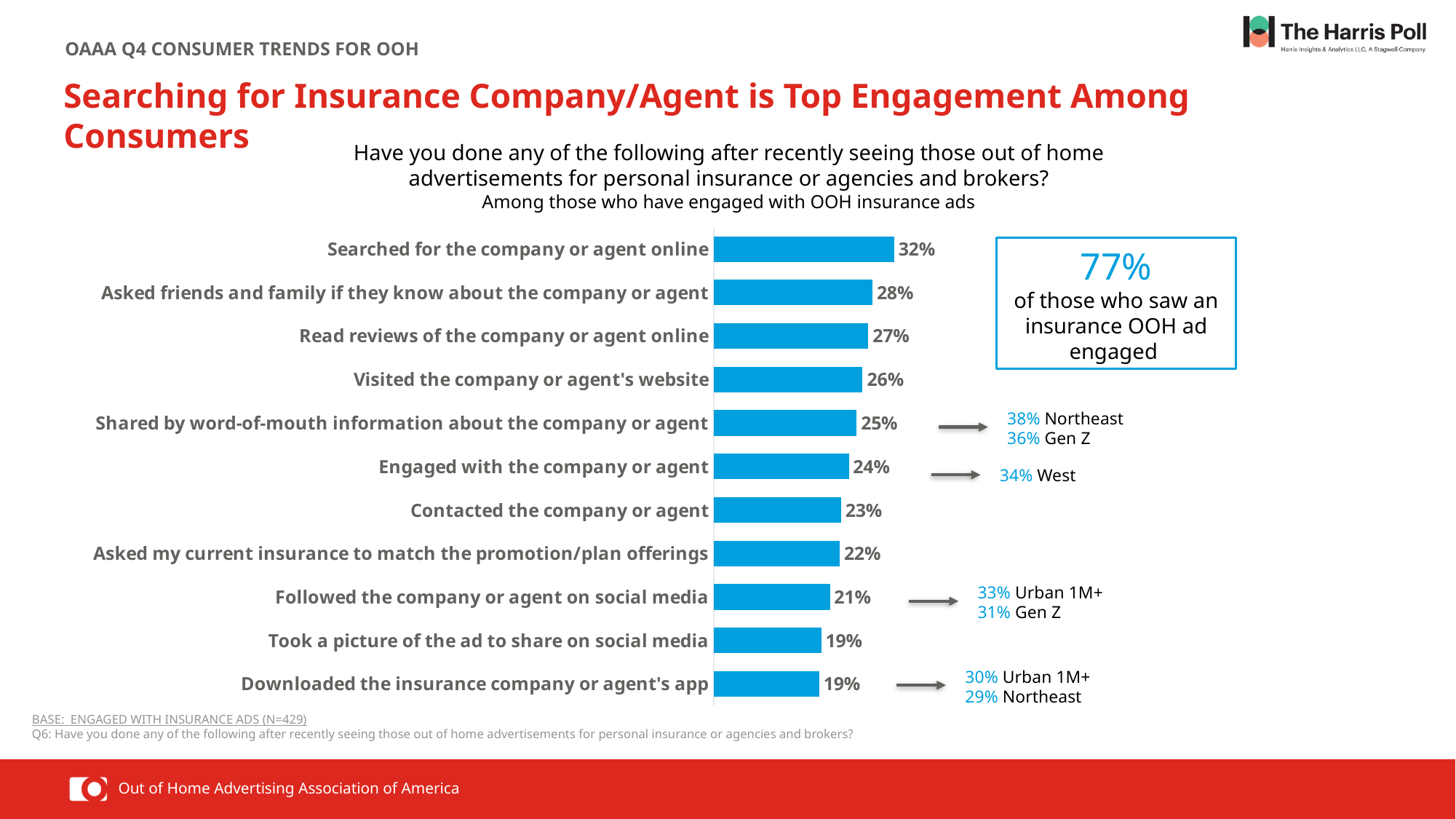
What kind of chart is shown on the slide? Bar chart Do the values rise or fall going from the top bar to the bottom bar? Fall What percentage followed the company or agent on social media? 21% What is the difference between 'Searched for the company or agent online' and 'Visited the company or agent's website'? 6% How many actions (categories) are listed in the chart? 11 What is the lowest value shown in the chart? 19% What percentage of those who saw an insurance OOH ad engaged, according to the callout box? 77% Which is larger: 'Contacted the company or agent' or 'Asked my current insurance to match the promotion/plan offerings'? Contacted the company or agent What is the base sample size (N) noted at the bottom of the chart? N=429 What percentage of respondents searched for the company or agent online? 32% Which action has the highest percentage in the chart? Searched for the company or agent online What is the value for 'Read reviews of the company or agent online'? 27%